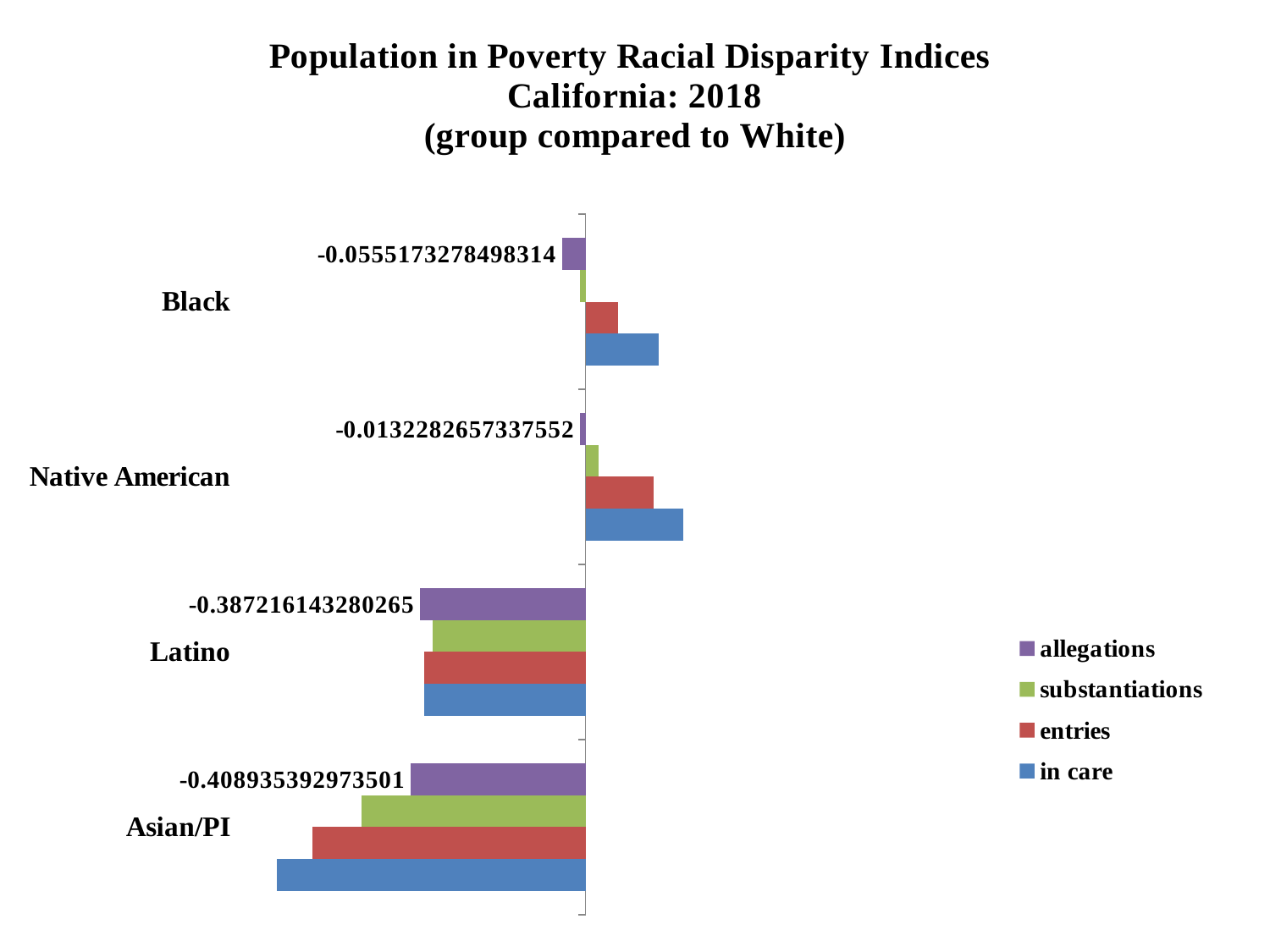
What is the allegations value for Black? -0.0555173278498314 What is the allegations value for Native American? -0.0132282657337552 What kind of chart is this? Bar chart Which group has the highest allegations value? Native American Which colour represents the 'in care' series in the legend? Blue What is the difference between the allegations values for Black and Native American? 0.0422890621160762 Which group has the lowest allegations value? Asian/PI What is the allegations value for Asian/PI? -0.408935392973501 How many groups are shown on the chart? 4 How many series does the legend list? 4 Which is larger, the allegations value for Black or for Latino? Black What is the allegations value for Latino? -0.387216143280265